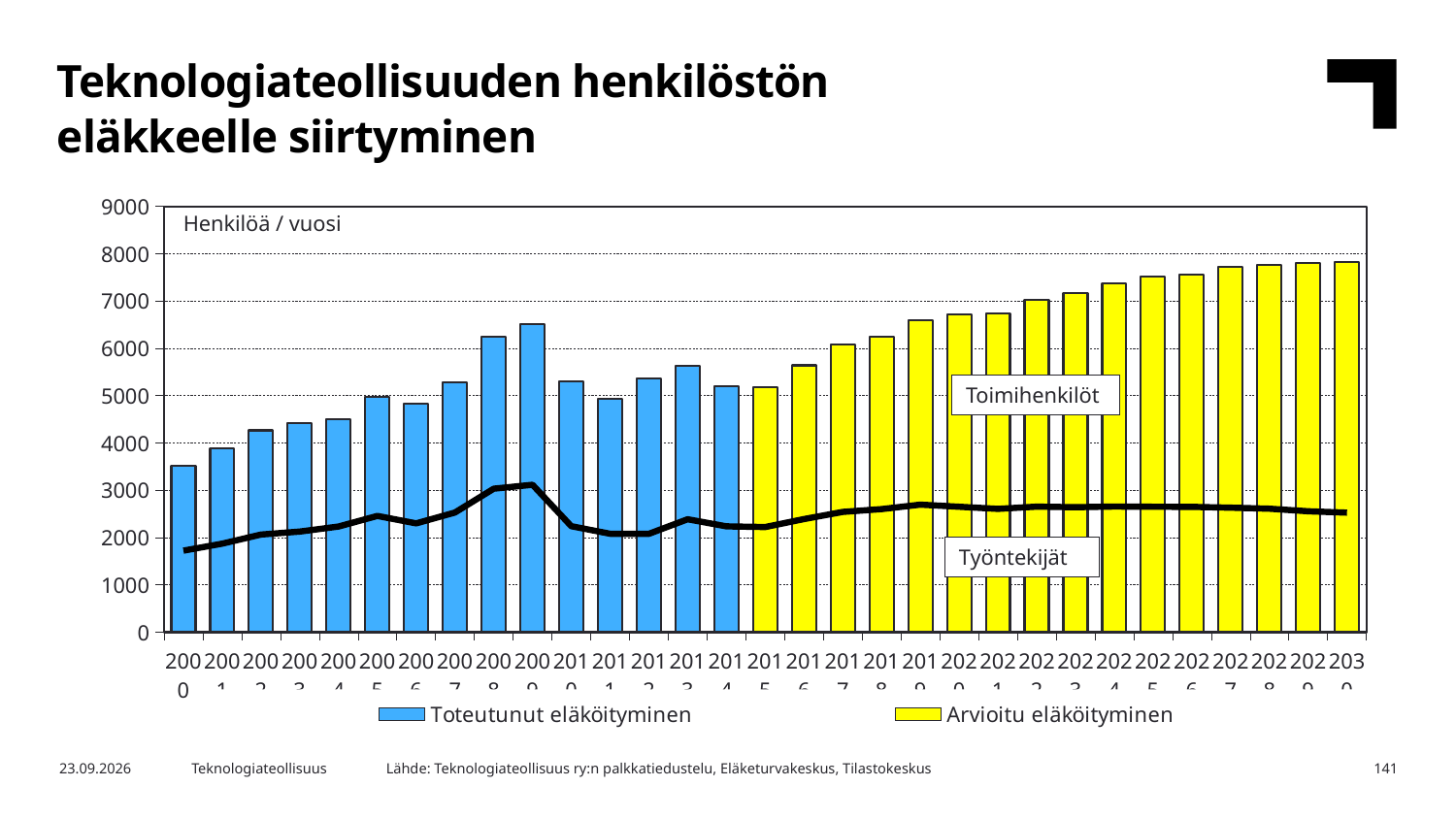
Is the bar for 2020 greater or less than 6000? greater Do the yellow (Arvioitu eläköityminen) bars rise or fall from 2015 to 2030? rise Is the bar for 2030 greater or less than 7000? greater What are the two entries in the legend? Toteutunut eläköityminen and Arvioitu eläköityminen Is the bar for 2009 greater or less than 6000? greater Which bar is taller, 2009 or 2014? 2009 How many years (bars) are shown along the x axis? 31 What kind of chart is shown on the slide? combination bar and line chart Which year has the lowest bar? 2000 What unit label is printed inside the top-left of the plot area? Henkilöä / vuosi How many series does the legend list? 2